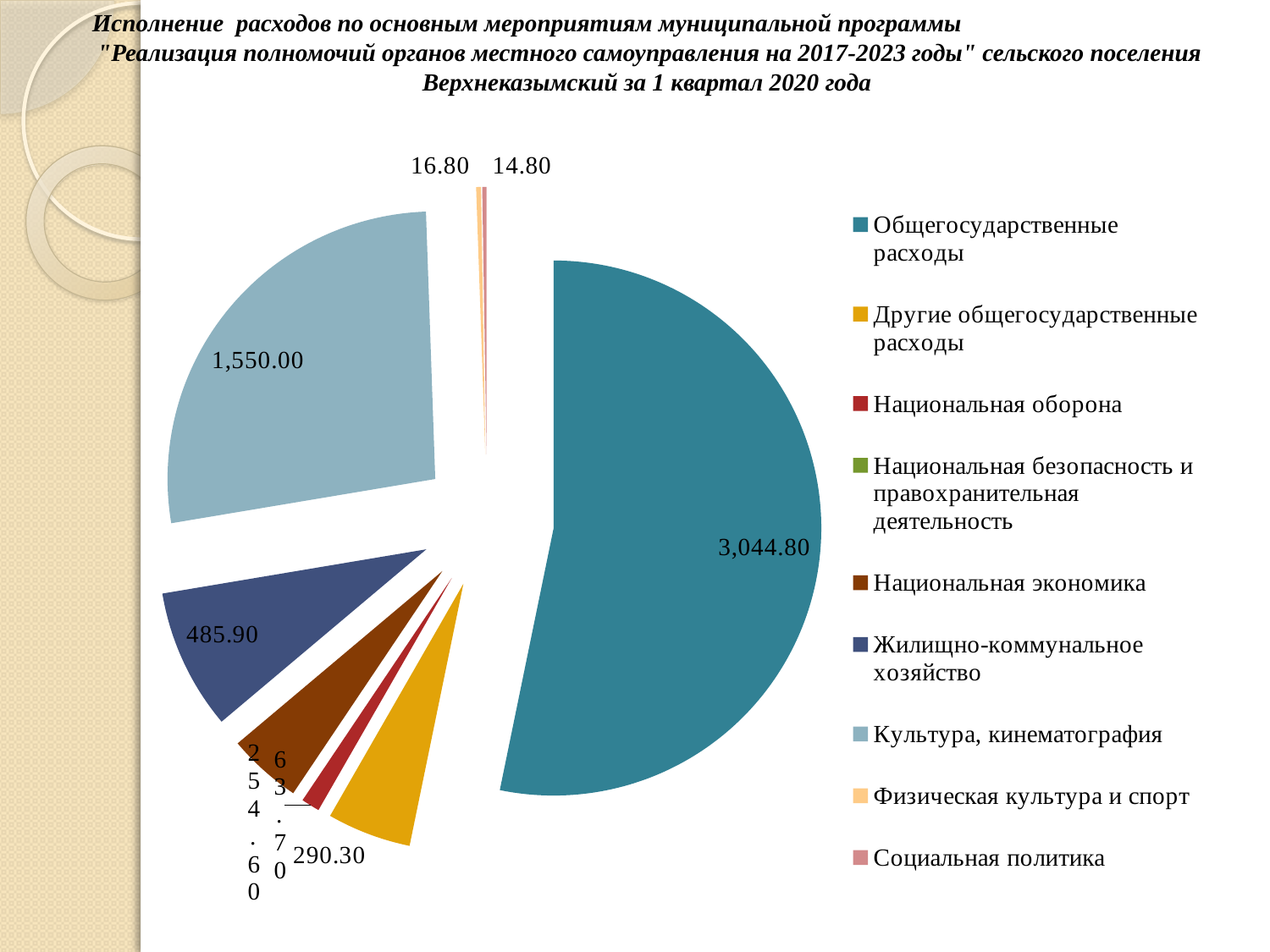
What is the value shown for Социальная политика? 14.80 Which is larger: Культура, кинематография or Жилищно-коммунальное хозяйство? Культура, кинематография What is the value shown for Жилищно-коммунальное хозяйство? 485.90 What is the value shown for Физическая культура и спорт? 16.80 What is the value shown for Другие общегосударственные расходы? 290.30 Which category has the largest slice of the pie? Общегосударственные расходы What is the value shown for Культура, кинематография? 1,550.00 What kind of chart is shown on the slide? pie chart What is the difference between the values for Жилищно-коммунальное хозяйство and Другие общегосударственные расходы? 195.60 How many categories does the legend of the pie chart list? 9 What is the difference between the values for Общегосударственные расходы and Культура, кинематография? 1,494.80 What is the value shown for Общегосударственные расходы? 3,044.80